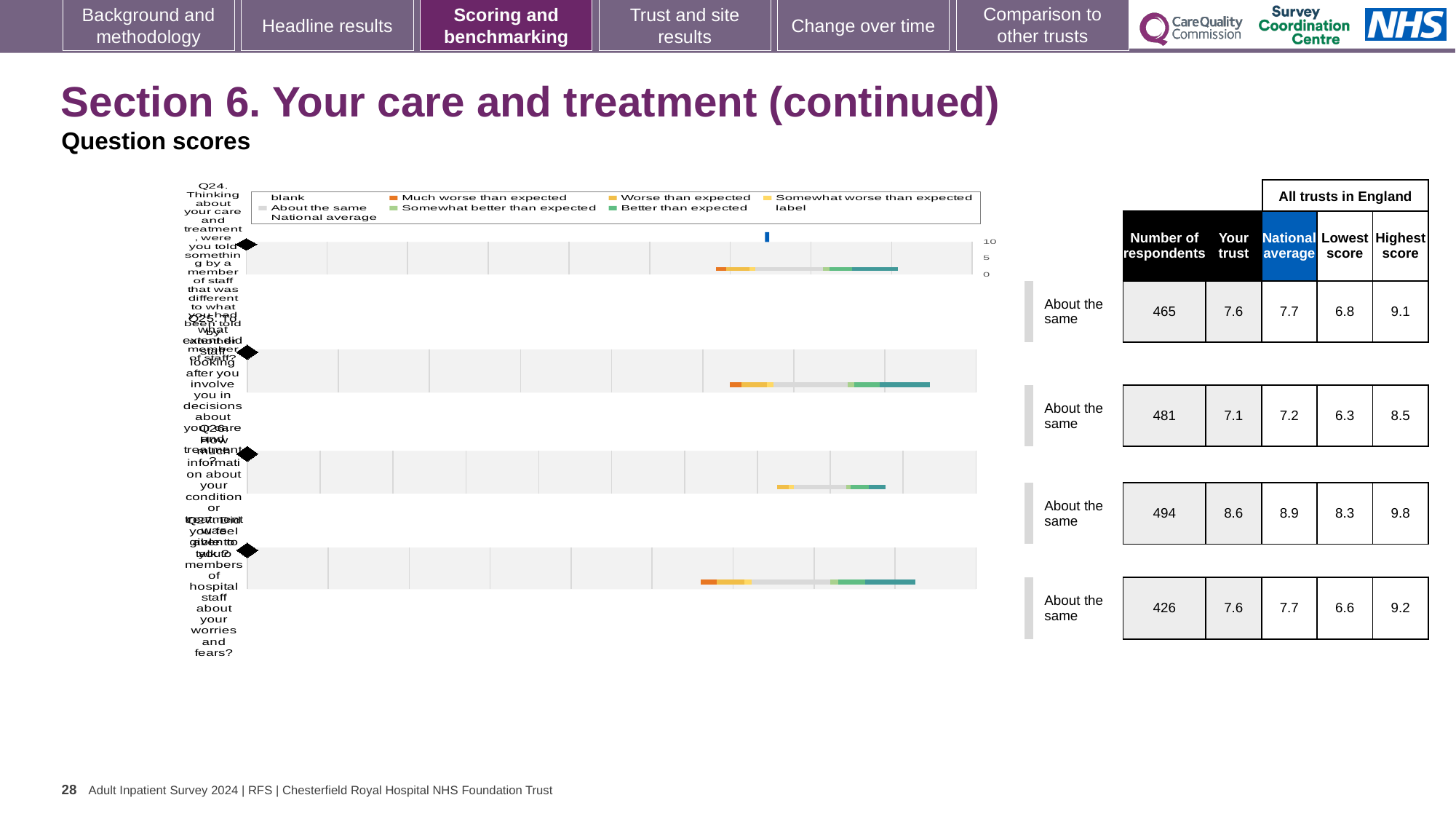
For the top chart row (465 respondents), is the 'Your trust' score larger or smaller than the national average? smaller What kind of chart is used for each question row on the slide? bar chart For the third chart row (494 respondents), what is the difference between the national average and the 'Your trust' score? 0.3 How many question rows (charts) are plotted on the slide? 4 Which chart row has the highest 'Your trust' score? the third row (494 respondents) Which legend entry is shown in orange? Much worse than expected For the bottom chart row (426 respondents), what is the lowest score among all trusts in England? 6.6 Which chart row has the lowest 'Your trust' score? the second row (481 respondents) For the second chart row (481 respondents), what is the national average score? 7.2 What benchmark category is shown beside the top chart row? About the same For the third chart row (494 respondents), what is the highest score among all trusts in England? 9.8 For the top chart row (465 respondents), what is the 'Your trust' score? 7.6